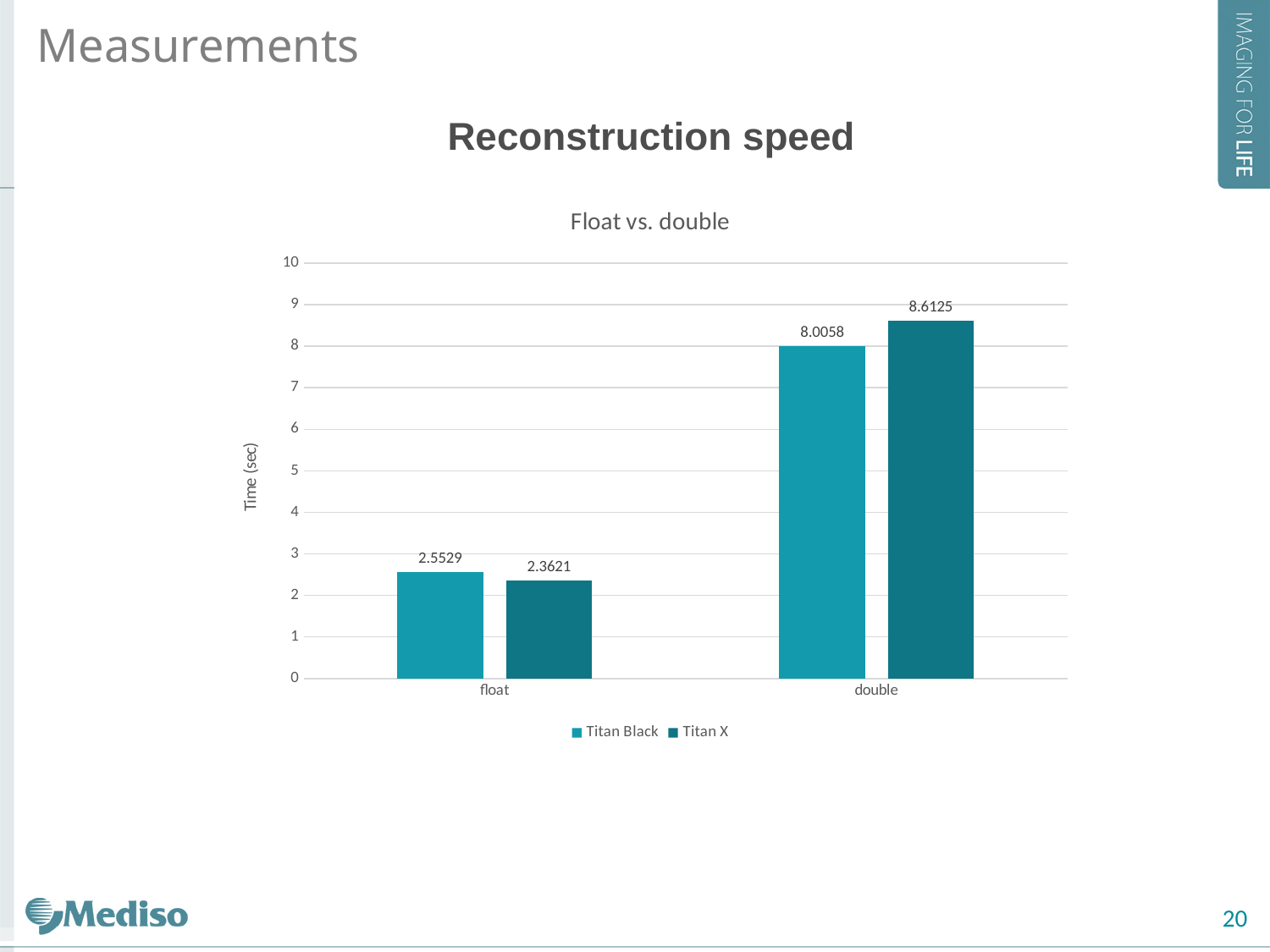
What is the Titan Black value for float? 2.5529 Which category has the lowest Titan Black value? float Is the Titan Black value for double greater or less than 7? greater What is the Titan Black value for double? 8.0058 For float, which series has the larger value, Titan Black or Titan X? Titan Black Which category has the highest Titan X value? double What is the Titan X value for float? 2.3621 What is the Titan X value for double? 8.6125 What is the difference between the Titan X and Titan Black values for double? 0.6067 What kind of chart is shown? bar chart How many series does the legend list? 2 How many categories are shown on the x axis? 2